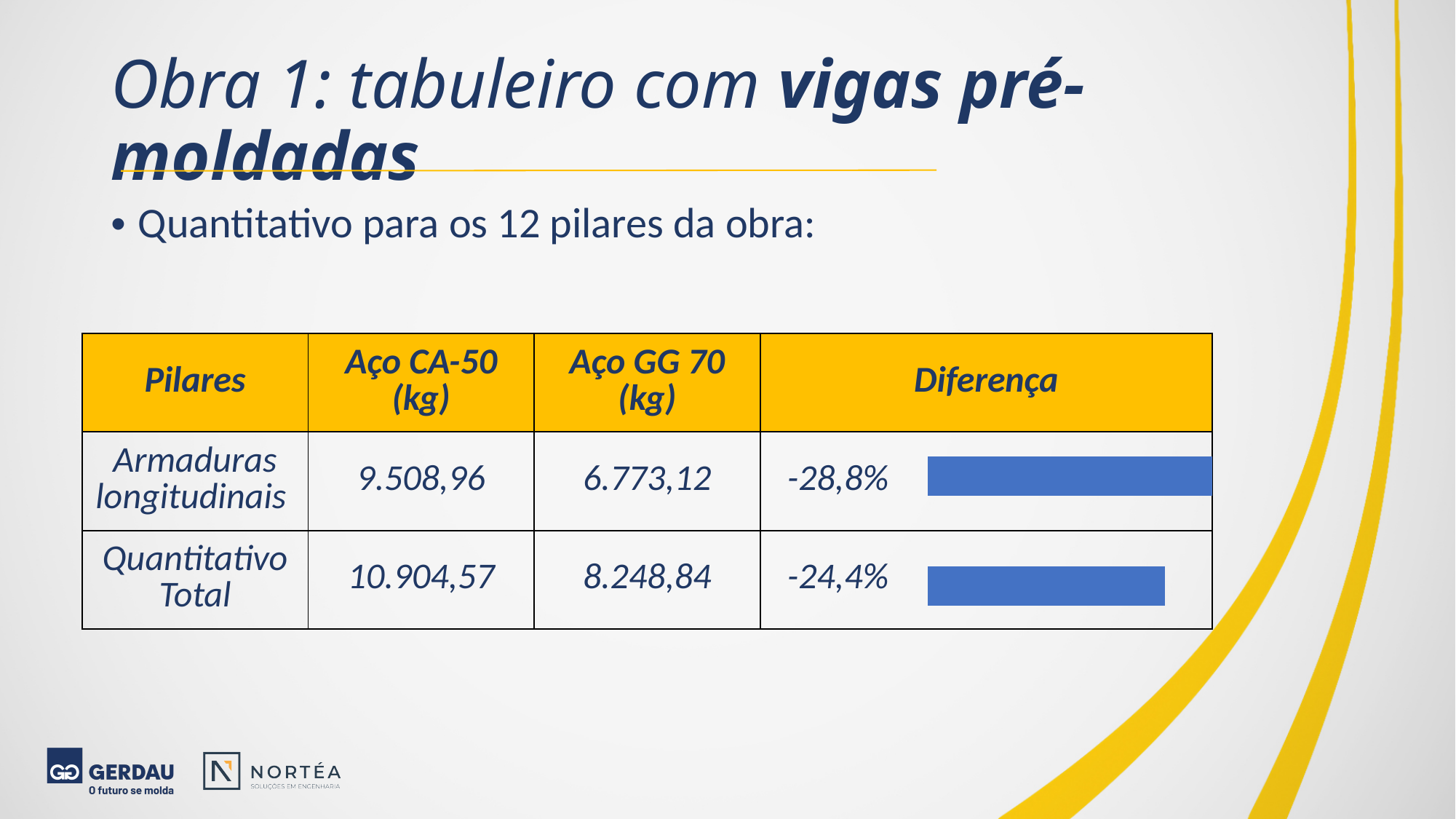
What is the Aço CA-50 (kg) value for Quantitativo Total? 10.904,57 What is the Aço GG 70 (kg) value for Armaduras longitudinais? 6.773,12 What is the Aço CA-50 (kg) value for Armaduras longitudinais? 9.508,96 What kind of chart is embedded in the Diferença column of the table? Bar chart What is the Aço GG 70 (kg) value for Quantitativo Total? 8.248,84 What is the Diferença value shown next to the bar for Armaduras longitudinais? -28,8% Which row shows the larger percentage reduction in the Diferença column? Armaduras longitudinais What colour are the bars in the Diferença column? Blue What is the Diferença value shown next to the bar for Quantitativo Total? -24,4% For Armaduras longitudinais, which is larger: the Aço CA-50 value or the Aço GG 70 value? Aço CA-50 Which row has the longer bar in the Diferença column? Armaduras longitudinais How many bars are drawn in the Diferença column? 2